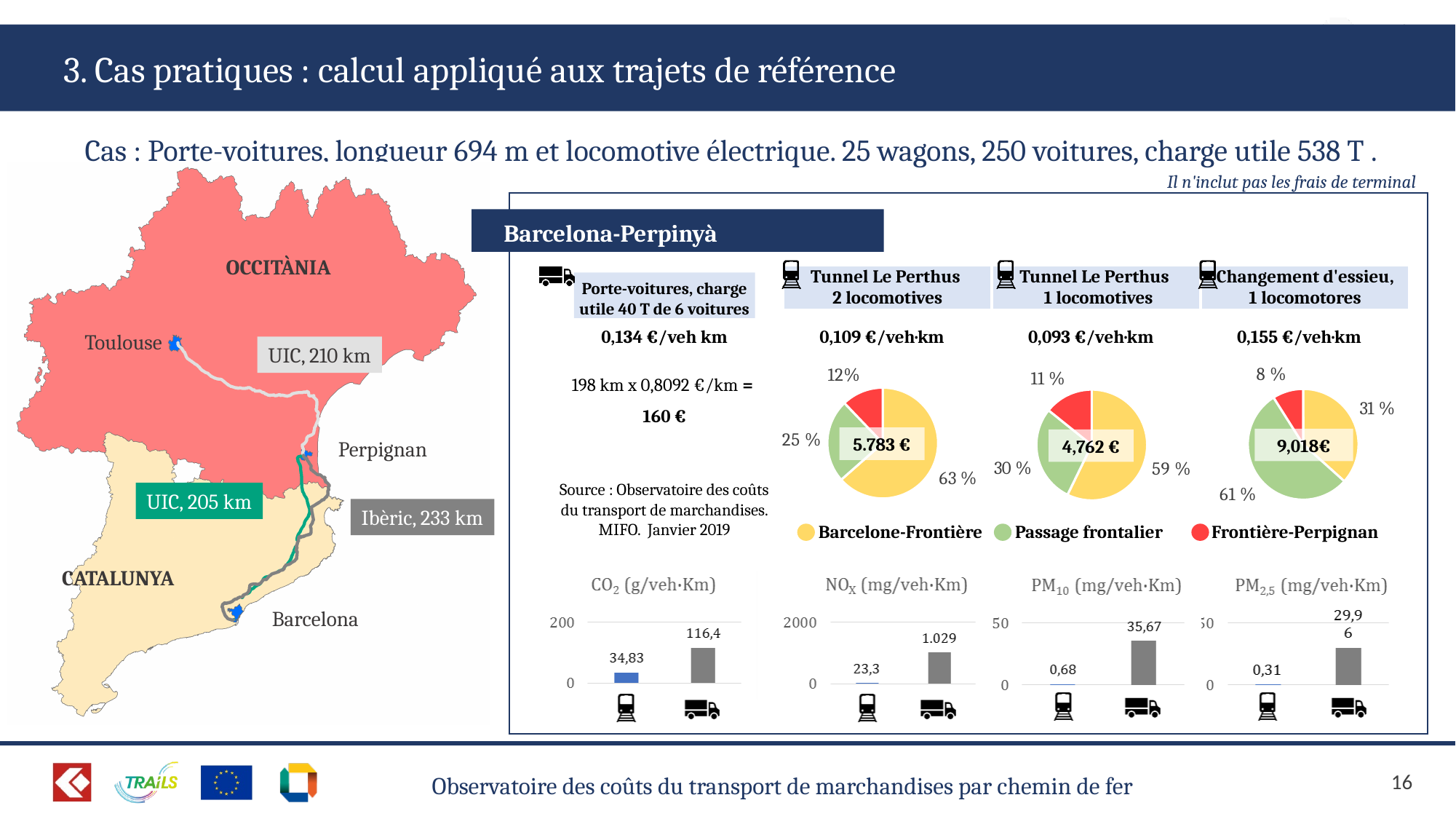
In the pie chart for Changement d'essieu, 1 locomotores, which segment is the largest? Passage frontalier In the CO2 (g/veh·Km) bar chart, what is the value for the train? 34,83 In the pie chart for Changement d'essieu, 1 locomotores, what share is Frontière-Perpignan? 8 % In the pie chart for Tunnel Le Perthus 2 locomotives, what share is Barcelone-Frontière? 63 % In the PM2,5 (mg/veh·Km) bar chart, which is larger, the train value or the truck value? truck In the PM10 (mg/veh·Km) bar chart, what is the difference between the truck and train values? 34,99 How many entries does the shared legend below the pie charts list? 3 In the pie chart for Tunnel Le Perthus 1 locomotives, what share is Passage frontalier? 30 % What kind of chart is used for the CO2 (g/veh·Km) emissions? bar chart In the NOx (mg/veh·Km) bar chart, what is the value for the truck? 1.029 In the pie chart for Tunnel Le Perthus 2 locomotives, which segment is the smallest? Frontière-Perpignan What total value is printed in the centre of the Tunnel Le Perthus 1 locomotives pie chart? 4,762 €